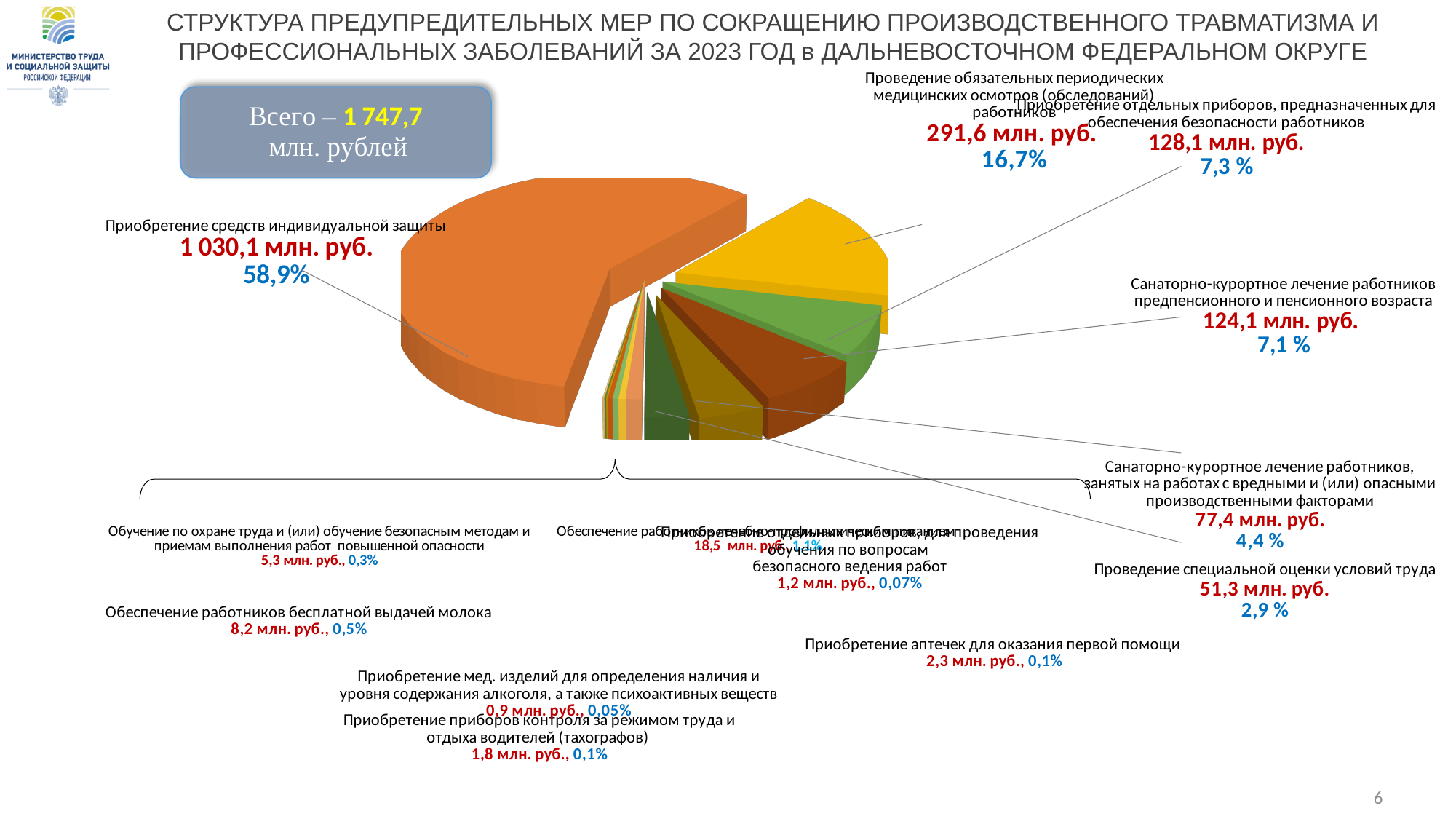
What percentage is shown for "Санаторно-курортное лечение работников предпенсионного и пенсионного возраста"? 7,1 % What share of the pie does "Приобретение средств индивидуальной защиты" represent? 58,9% What is the value for "Приобретение средств индивидуальной защиты"? 1 030,1 млн. руб. What is the total amount shown for all preventive measures? 1 747,7 млн. рублей What type of chart is shown on the slide? Pie chart Which category has the largest share of the pie? Приобретение средств индивидуальной защиты What is the value for "Обеспечение работников бесплатной выдачей молока"? 8,2 млн. руб. What is the difference in млн. руб. between "Проведение обязательных периодических медицинских осмотров" and "Приобретение отдельных приборов, предназначенных для обеспечения безопасности работников"? 163,5 млн. руб. What is the value for "Проведение обязательных периодических медицинских осмотров (обследований) работников"? 291,6 млн. руб. Which category has the smallest value shown on the slide? Приобретение мед. изделий для определения наличия и уровня содержания алкоголя, а также психоактивных веществ Which is larger: "Приобретение отдельных приборов, предназначенных для обеспечения безопасности работников" or "Санаторно-курортное лечение работников предпенсионного и пенсионного возраста"? Приобретение отдельных приборов, предназначенных для обеспечения безопасности работников What is the value for "Проведение специальной оценки условий труда"? 51,3 млн. руб.